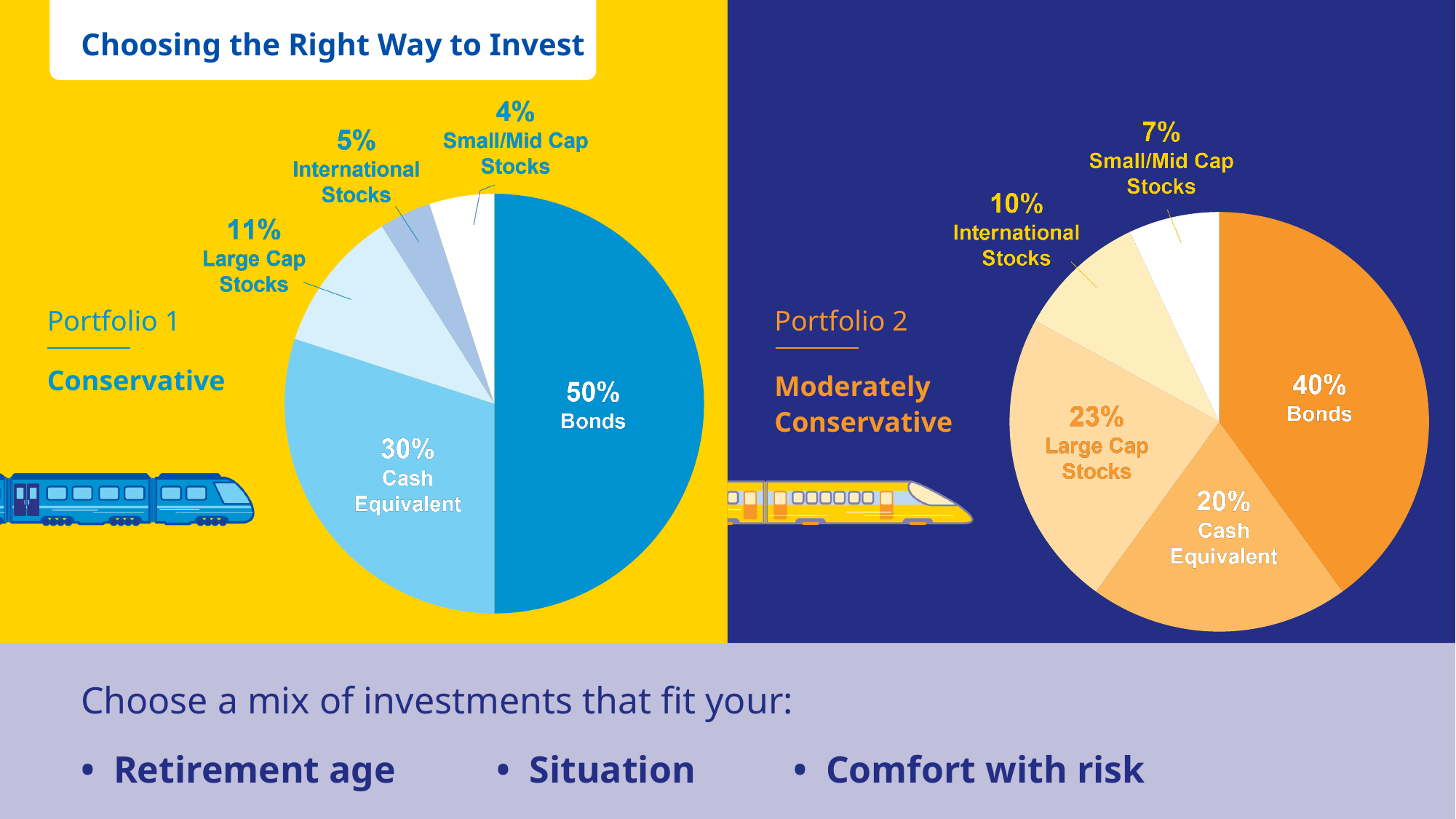
Which portfolio allocates a larger share to Large Cap Stocks, Portfolio 1 or Portfolio 2? Portfolio 2 In the Portfolio 2 (Moderately Conservative) pie chart, what share is allocated to Cash Equivalent? 20% What type of chart is used for Portfolio 1 (Conservative)? Pie chart In the Portfolio 1 (Conservative) pie chart, what share is allocated to International Stocks? 5% In the Portfolio 1 (Conservative) pie chart, which category has the largest share? Bonds How many categories does the Portfolio 2 (Moderately Conservative) pie chart show? 5 In the Portfolio 2 (Moderately Conservative) pie chart, what is the combined share of Bonds and Cash Equivalent? 60% In the Portfolio 1 (Conservative) pie chart, what is the difference between the Bonds share and the Cash Equivalent share? 20% In the Portfolio 2 (Moderately Conservative) pie chart, which category has the smallest share? Small/Mid Cap Stocks In the Portfolio 1 (Conservative) pie chart, what share is allocated to Bonds? 50% What is the title of the slide containing the two pie charts? Choosing the Right Way to Invest In the Portfolio 2 (Moderately Conservative) pie chart, what share is allocated to Large Cap Stocks? 23%